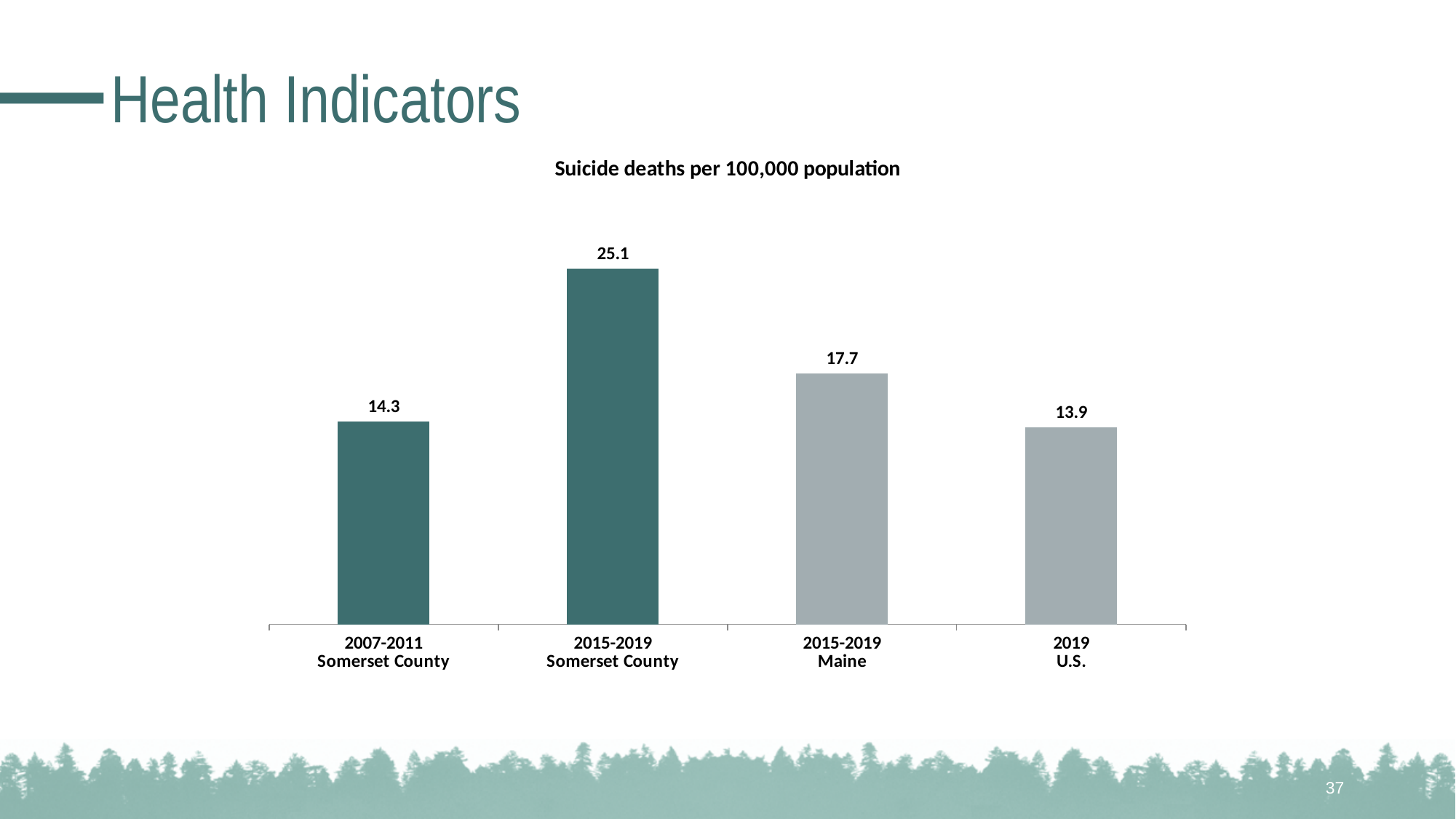
What is the title of the chart? Suicide deaths per 100,000 population Which is larger, the value for 2015-2019 Maine or the value for 2019 U.S.? 2015-2019 Maine What is the value for 2019 U.S.? 13.9 What is the value for 2015-2019 Somerset County? 25.1 What kind of chart is shown on the slide? Bar chart How many categories are shown in the chart? 4 What is the difference between the 2015-2019 Somerset County value and the 2015-2019 Maine value? 7.4 What is the value for 2007-2011 Somerset County? 14.3 What is the difference between the 2015-2019 Somerset County value and the 2007-2011 Somerset County value? 10.8 Which category has the lowest value? 2019 U.S. Which category has the highest value? 2015-2019 Somerset County What is the value for 2015-2019 Maine? 17.7